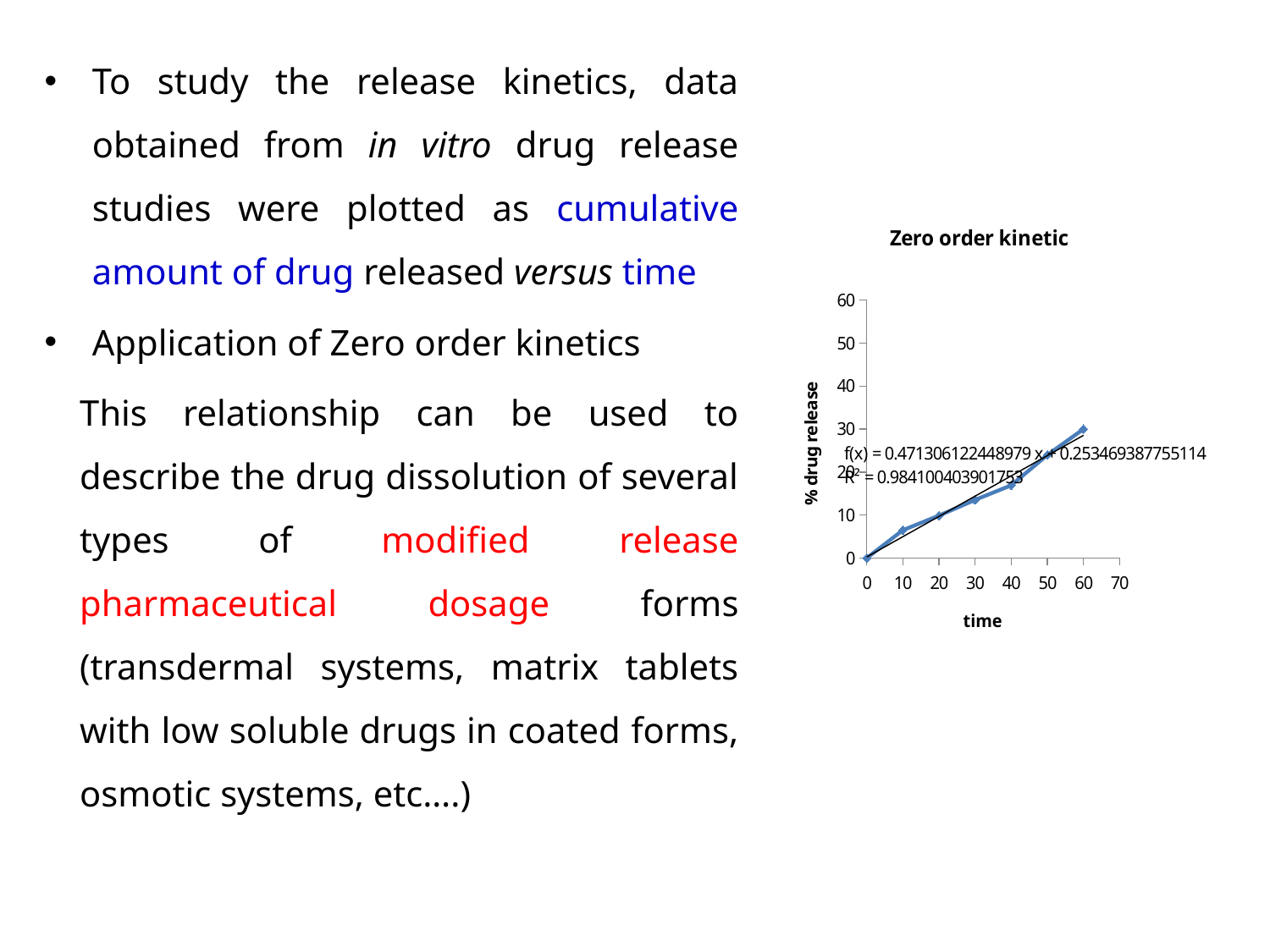
What is the title of the chart? Zero order kinetic At which time is the % drug release lowest? 0 Is the % drug release at time 10 greater or less than 10? less Is the % drug release at time 60 greater or less than 20? greater What R² value is printed on the chart for the trendline? 0.984100403901753 Which has a larger % drug release, time 20 or time 50? time 50 What kind of chart is shown on the slide? line chart What is the label of the y axis of the chart? % drug release How many data points are plotted on the chart? 7 At which time is the % drug release highest? 60 Do the plotted values rise or fall as time increases along the x axis? rise Is the % drug release at time 40 greater or less than 30? less